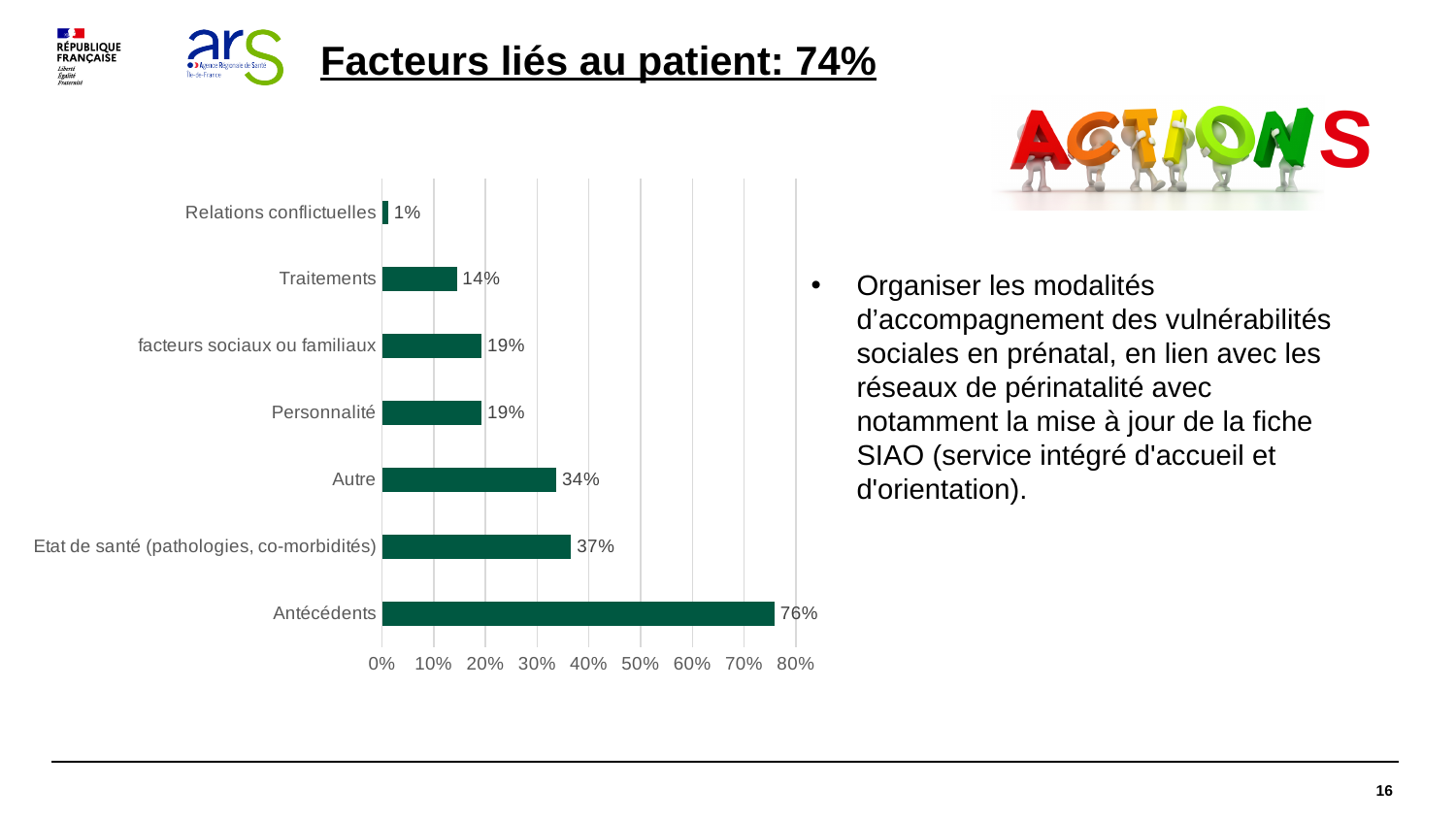
What is the value for Relations conflictuelles? 1% How many categories are shown in the chart? 7 What is the value for Antécédents? 76% Which category has the lowest value? Relations conflictuelles Is the value for Autre greater or less than 30%? greater Which two categories share the same value of 19%? facteurs sociaux ou familiaux and Personnalité What is the value for Etat de santé (pathologies, co-morbidités)? 37% Which category has the highest value? Antécédents What kind of chart is shown on the slide? Bar chart Which is larger, the value for Autre or the value for Traitements? Autre What is the difference between the values for Antécédents and Etat de santé (pathologies, co-morbidités)? 39% What is the value for Traitements? 14%